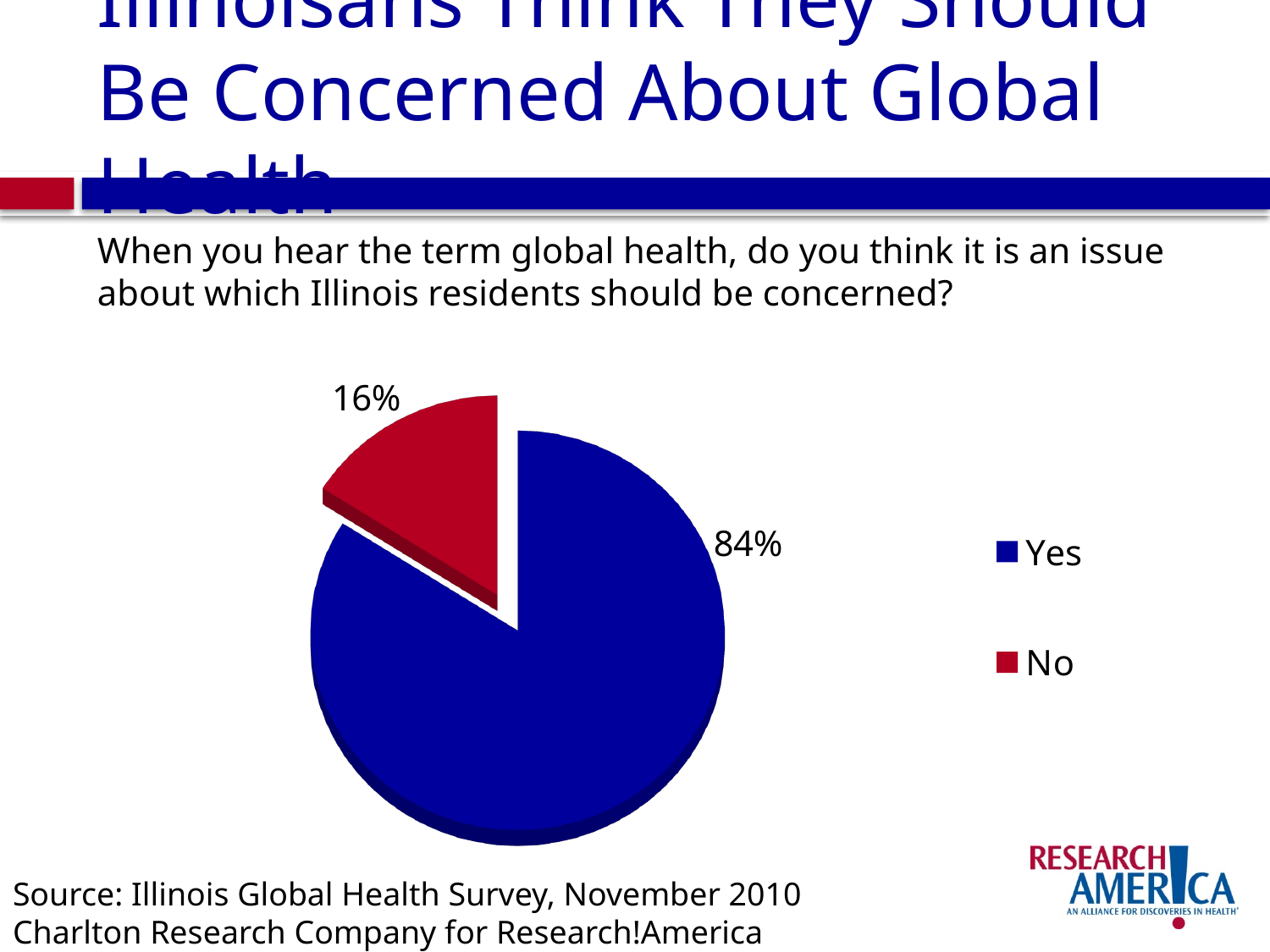
How many slices does the pie chart have? 2 Which is larger, the share for Yes or the share for No? Yes What colour is the No slice of the pie? Red How many entries does the legend list? 2 What kind of chart is shown on the slide? Pie chart Which response has the smallest share of the pie? No What percentage of respondents answered No? 16% Which response has the largest share of the pie? Yes What colour is the Yes slice of the pie? Blue What share of the pie does the No slice represent? 16% What percentage of respondents answered Yes? 84% What is the difference in percentage points between the Yes and No responses? 68